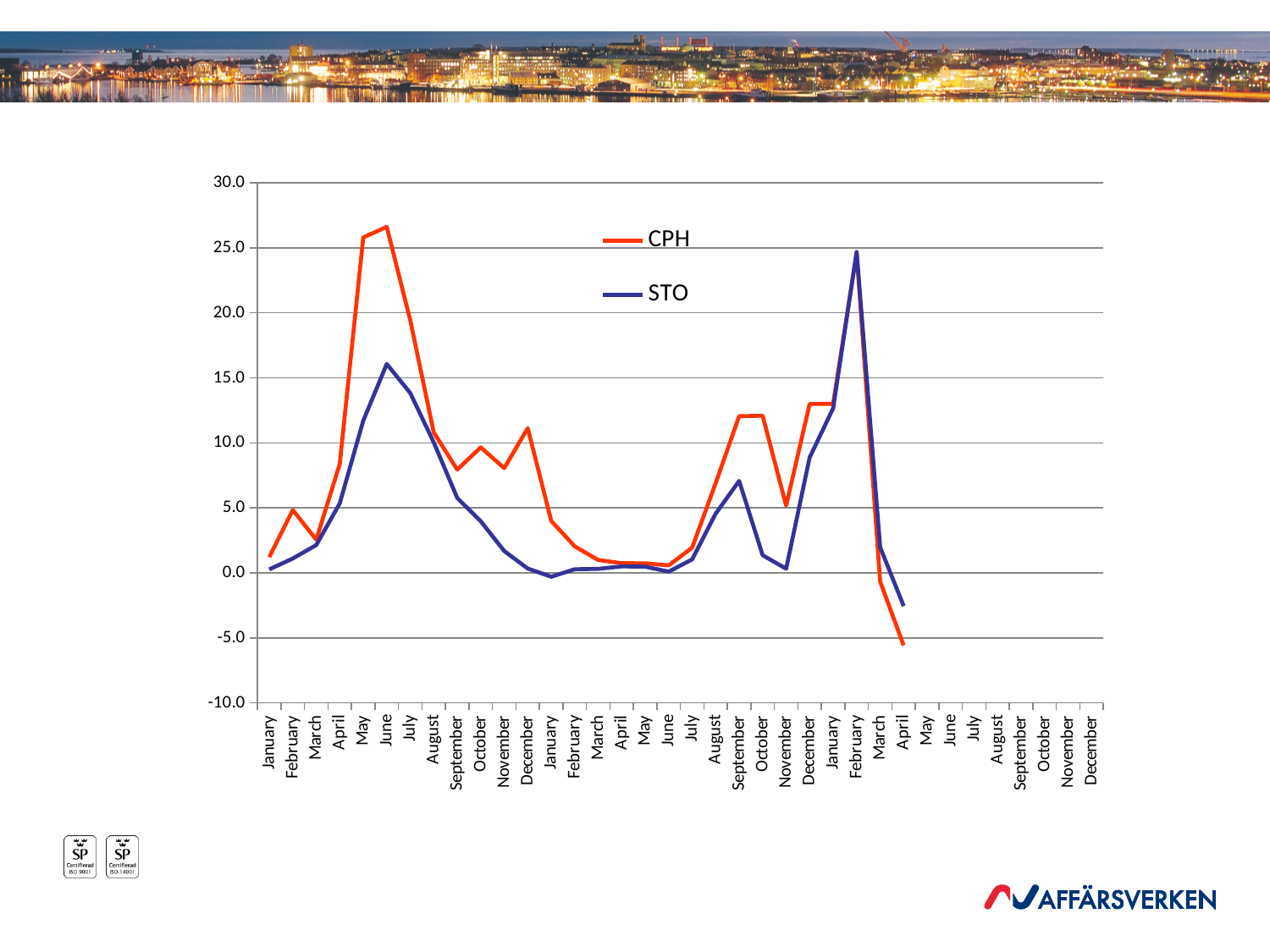
Do both lines rise or fall between the third February and the third April? fall In the first June, which series has the larger value, CPH or STO? CPH How many series does the legend list? 2 How many times does the label "January" appear on the x axis? 3 Is the value for CPH in the first June greater or less than 25.0? greater What are the two series named in the legend? CPH and STO Is the value for STO in the first June greater or less than 15.0? greater Is the value for STO in the third February greater or less than 20.0? greater Which series reaches the highest value anywhere on the chart? CPH Which colour is used for the STO line? blue What kind of chart is shown on the slide? line chart